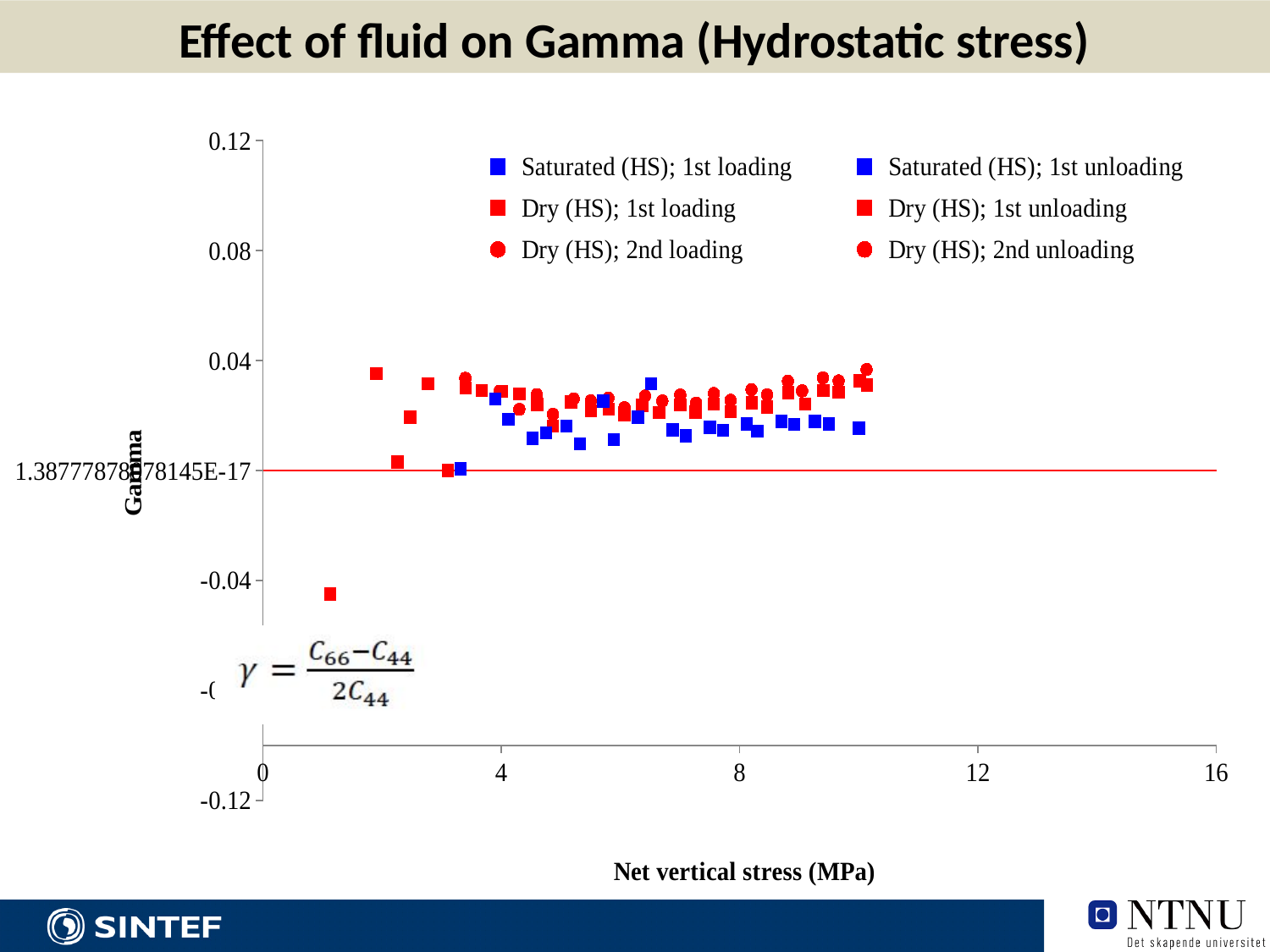
What is the title of the chart? Effect of fluid on Gamma (Hydrostatic stress) At around 8 MPa, which has higher Gamma values: the Dry (HS) series or the Saturated (HS) series? Dry (HS) Is the lowest plotted Gamma value (the Dry (HS); 1st loading point near 1 MPa) greater or less than -0.04? less What is the label of the x axis? Net vertical stress (MPa) What kind of chart is shown on the slide? Scatter chart Is the highest plotted Gamma value greater or less than 0.08? less How many series does the legend list? 6 Are the Saturated (HS); 1st loading values at around 8 MPa greater or less than 0.04? less